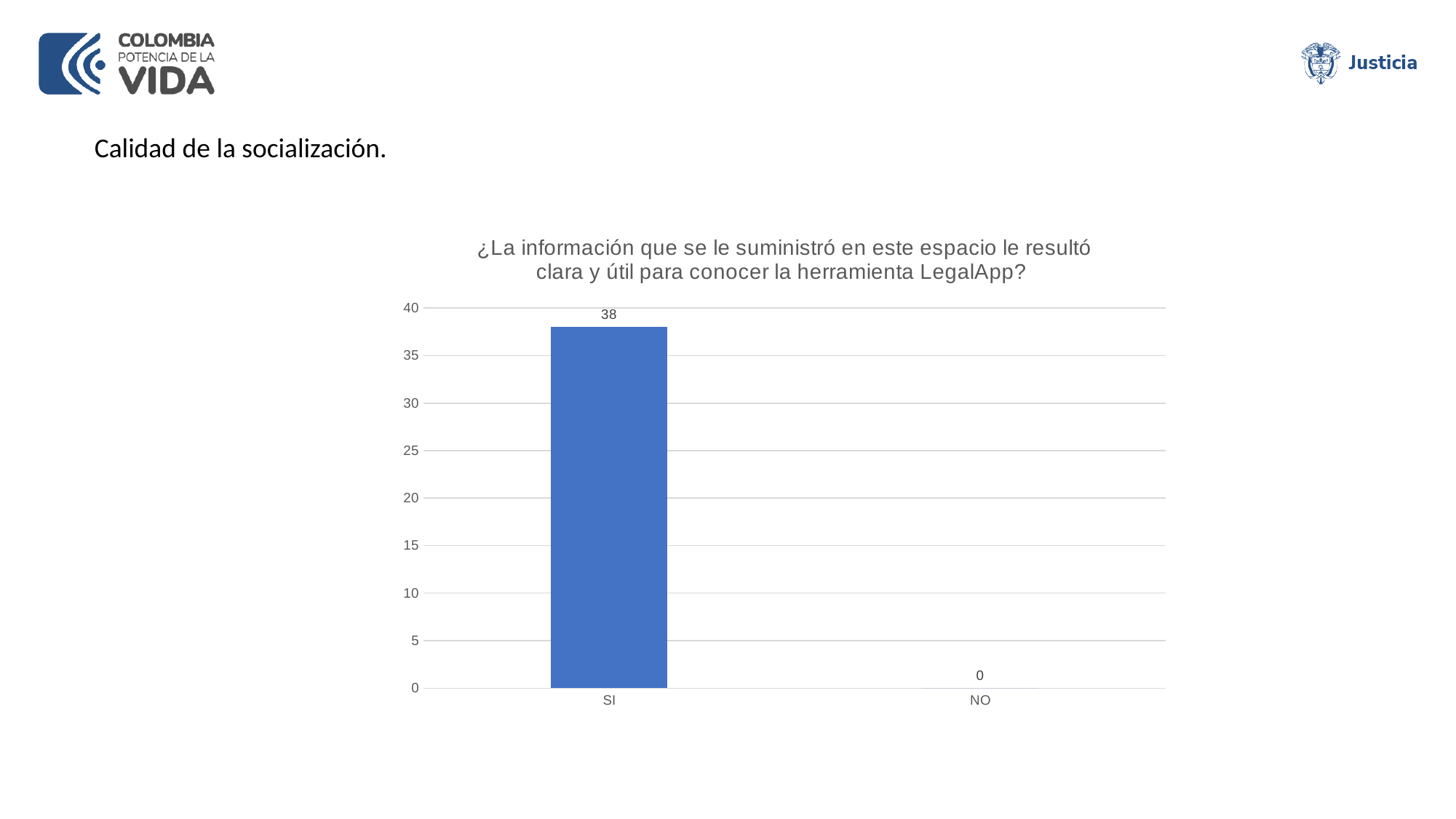
What is the value for NO? 0 Which category has the lowest value? NO Is the value for SI greater or less than 35? greater What is the value for SI? 38 What is the difference between the values for SI and NO? 38 What is the total of the values for SI and NO? 38 How many categories are shown on the x axis? 2 What is the highest value shown on the y axis? 40 What is the title of the chart? ¿La información que se le suministró en este espacio le resultó clara y útil para conocer la herramienta LegalApp? Which category has the highest value? SI Which is larger, the value for SI or the value for NO? SI What kind of chart is shown on the slide? bar chart